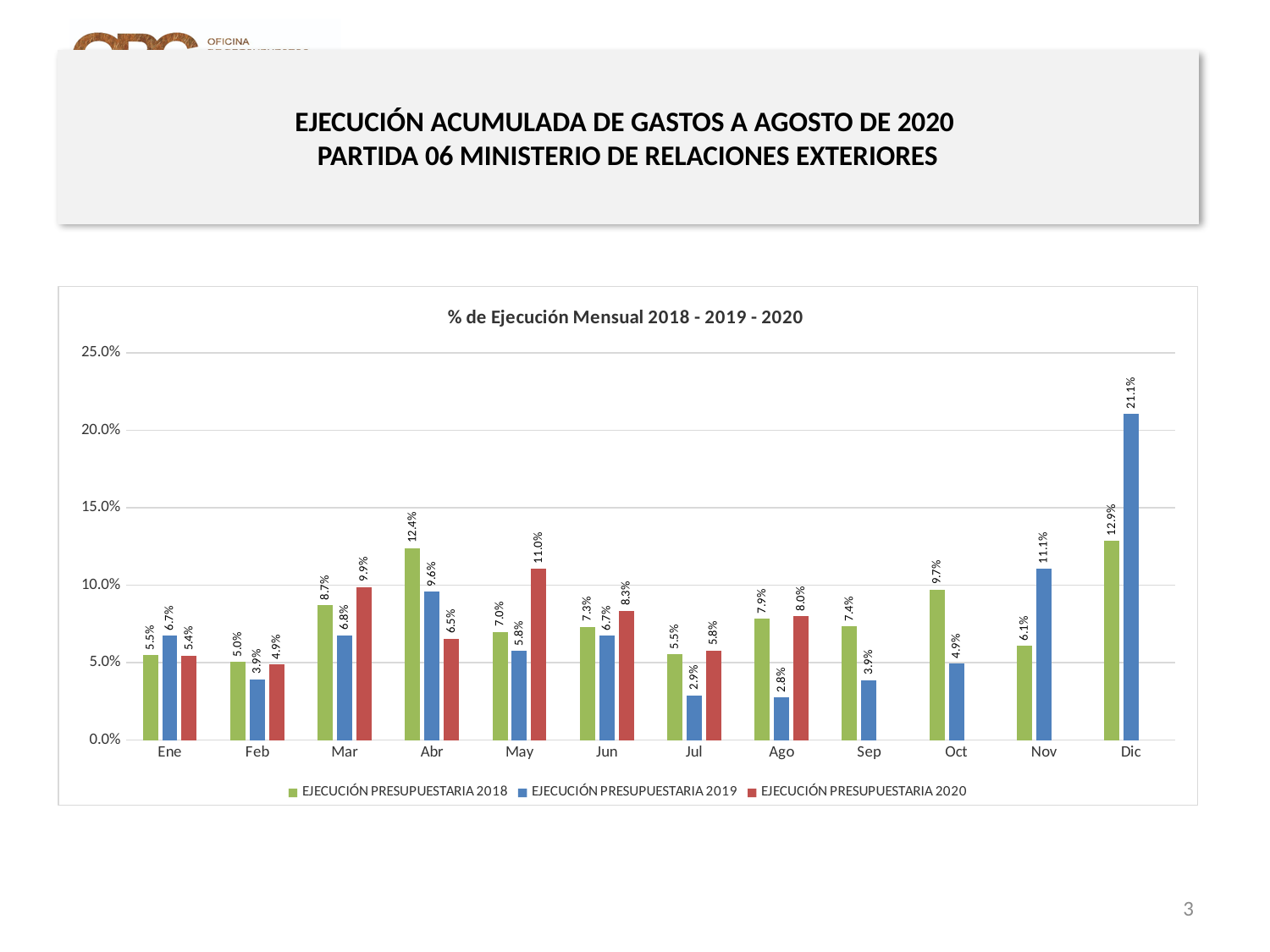
What is the difference between EJECUCIÓN PRESUPUESTARIA 2019 and EJECUCIÓN PRESUPUESTARIA 2018 in Dic? 8.2% Which month has the lowest value for EJECUCIÓN PRESUPUESTARIA 2019? Ago How many months are shown on the x axis? 12 What is the title of the chart? % de Ejecución Mensual 2018 - 2019 - 2020 How many series does the legend list? 3 What is the value for EJECUCIÓN PRESUPUESTARIA 2018 in Abr? 12.4% What kind of chart is shown on the slide? Bar chart What is the value for EJECUCIÓN PRESUPUESTARIA 2019 in Dic? 21.1% Which month has the highest value for EJECUCIÓN PRESUPUESTARIA 2018? Dic Which is larger in Abr: EJECUCIÓN PRESUPUESTARIA 2018 or EJECUCIÓN PRESUPUESTARIA 2020? EJECUCIÓN PRESUPUESTARIA 2018 What is the value for EJECUCIÓN PRESUPUESTARIA 2020 in May? 11.0% Which month is the last one with a value for EJECUCIÓN PRESUPUESTARIA 2020? Ago